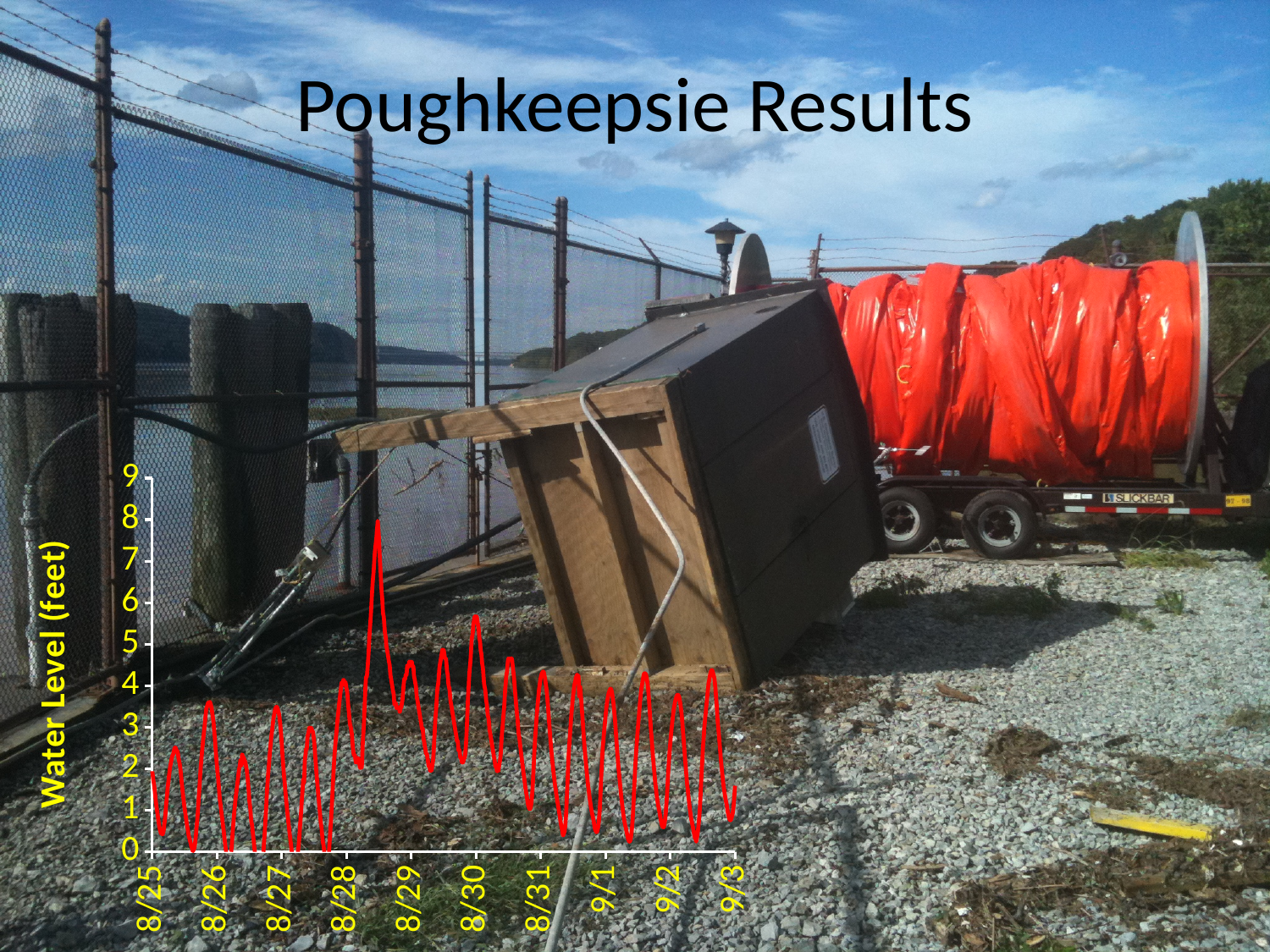
How many lines are plotted on the chart? 1 What is the first date labelled on the horizontal axis? 8/25 Does the highest peak of the water level occur before or after 8/28? after Are the lowest troughs of the water level line greater or less than 1 foot? less Is the highest peak of the water level line greater or less than 7 feet? greater What is the title of the slide containing the chart? Poughkeepsie Results What is the highest value labelled on the vertical axis? 9 What kind of chart is shown on the slide? line chart How many date ticks are labelled on the horizontal axis? 10 What is the label on the vertical axis of the chart? Water Level (feet) Is the water level at 8/25 greater or less than 3 feet? less What is the last date labelled on the horizontal axis? 9/3